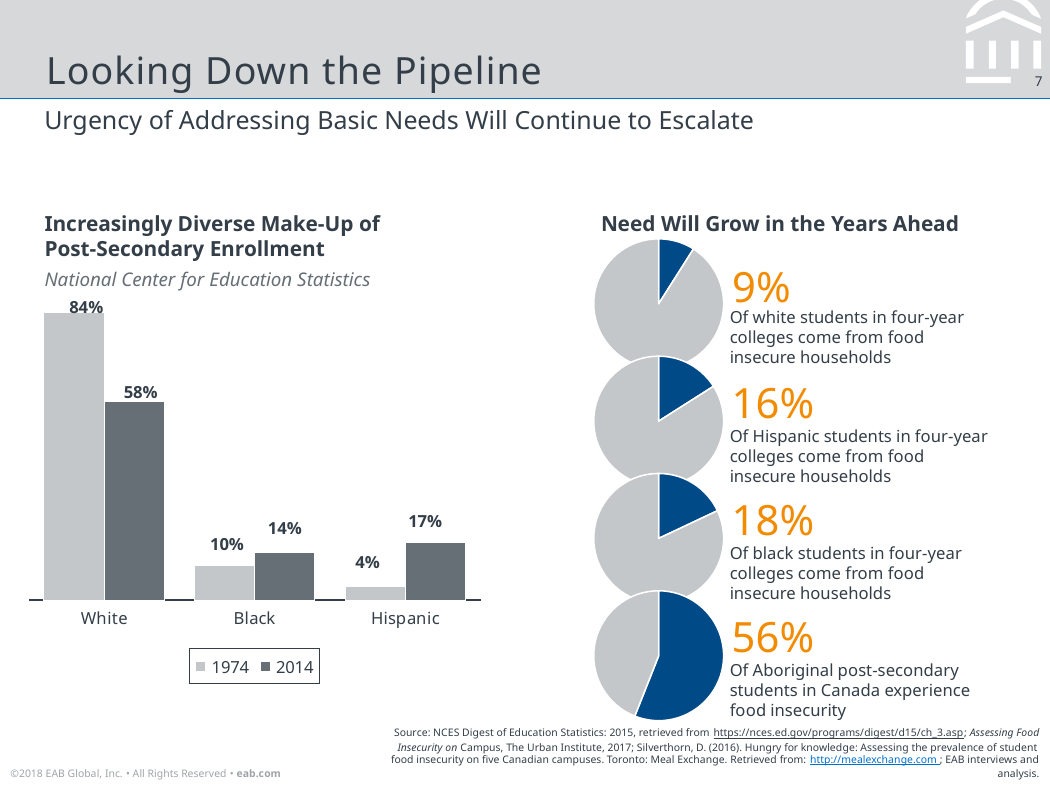
In the bar chart 'Increasingly Diverse Make-Up of Post-Secondary Enrollment', which category has the lowest value for 1974? Hispanic In the bar chart 'Increasingly Diverse Make-Up of Post-Secondary Enrollment', what is the value for Hispanic in 2014? 17% In the bar chart 'Increasingly Diverse Make-Up of Post-Secondary Enrollment', which category has the highest value for 2014? White In the pie charts under 'Need Will Grow in the Years Ahead', which group has the largest highlighted share? Aboriginal post-secondary students in Canada In the bar chart 'Increasingly Diverse Make-Up of Post-Secondary Enrollment', what is the value for White in 1974? 84% In the bar chart 'Increasingly Diverse Make-Up of Post-Secondary Enrollment', what is the difference between the White values for 1974 and 2014? 26% How many categories are shown on the x axis of the bar chart 'Increasingly Diverse Make-Up of Post-Secondary Enrollment'? 3 What kind of chart is 'Increasingly Diverse Make-Up of Post-Secondary Enrollment'? Bar chart In the bar chart 'Increasingly Diverse Make-Up of Post-Secondary Enrollment', which is larger for 2014: Black or Hispanic? Hispanic In the pie charts under 'Need Will Grow in the Years Ahead', what share of Hispanic students in four-year colleges come from food insecure households? 16% How many series does the legend of the bar chart 'Increasingly Diverse Make-Up of Post-Secondary Enrollment' list? 2 In the bar chart 'Increasingly Diverse Make-Up of Post-Secondary Enrollment', what is the value for Black in 1974? 10%